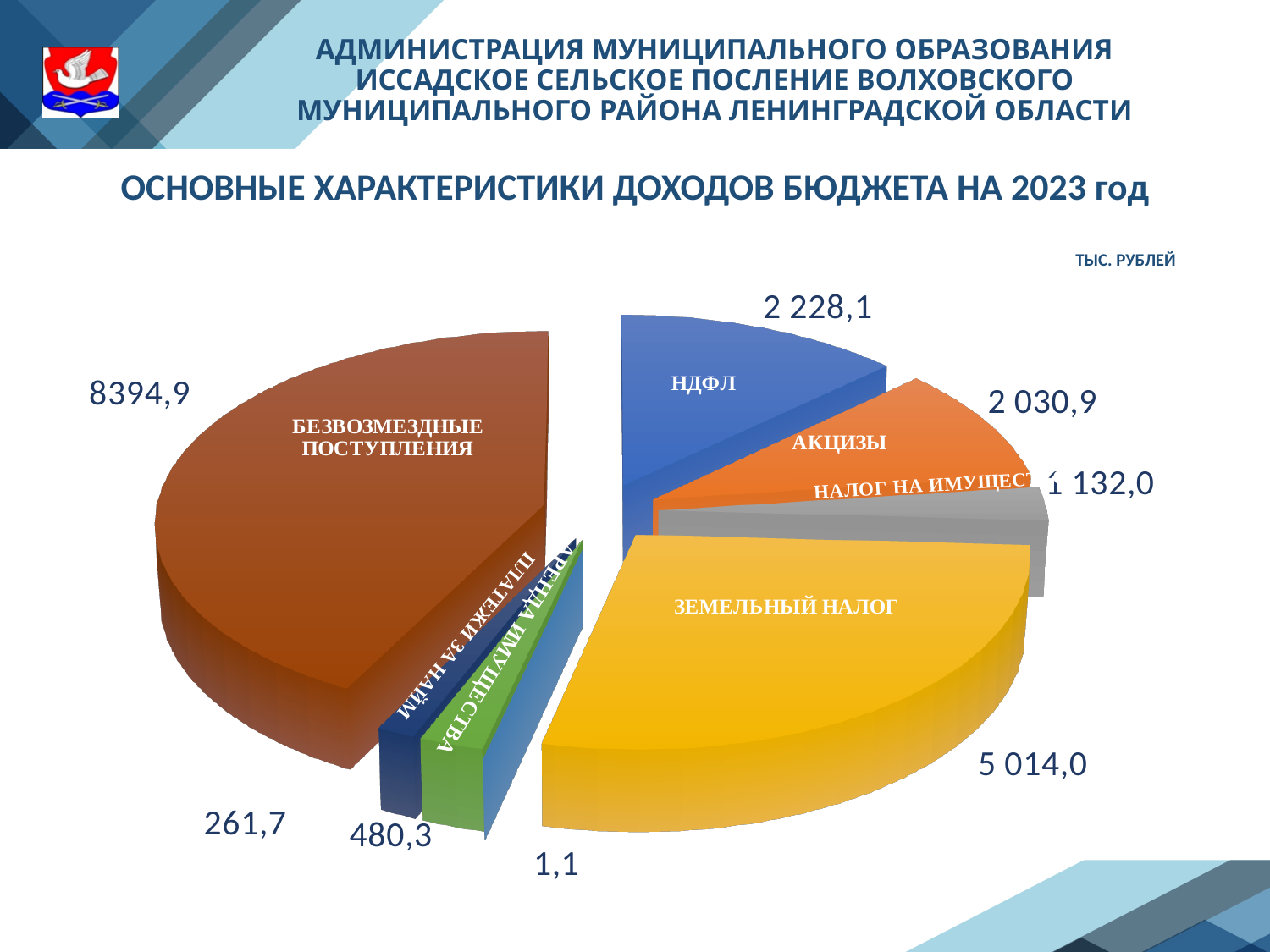
What is the difference between НДФЛ and АКЦИЗЫ? 197,2 What is the value for НДФЛ? 2 228,1 Which category has the largest slice of the pie? БЕЗВОЗМЕЗДНЫЕ ПОСТУПЛЕНИЯ What is the difference between ЗЕМЕЛЬНЫЙ НАЛОГ and НДФЛ? 2 785,9 What is the value for БЕЗВОЗМЕЗДНЫЕ ПОСТУПЛЕНИЯ? 8394,9 What is the value for НАЛОГ НА ИМУЩЕСТВО? 1 132,0 What kind of chart is shown on the slide? pie chart In what units are the values on the chart given? ТЫС. РУБЛЕЙ Which is larger, НДФЛ or АКЦИЗЫ? НДФЛ What is the value for ЗЕМЕЛЬНЫЙ НАЛОГ? 5 014,0 What is the value for АКЦИЗЫ? 2 030,9 How many slices does the pie chart have? 8